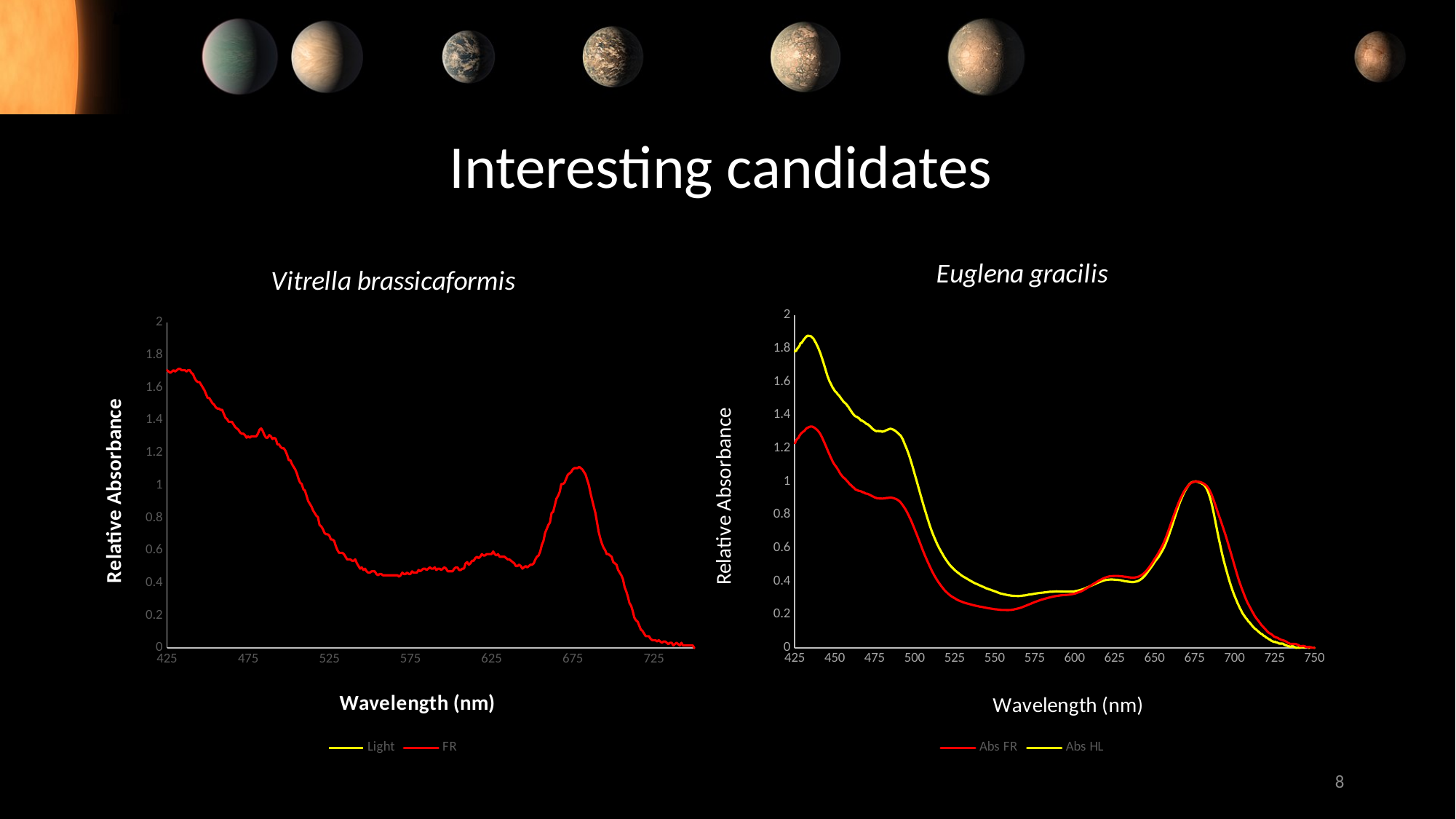
In the Vitrella brassicaformis chart, is the FR value at 725 nm greater or less than 0.2? less In the Vitrella brassicaformis chart, is the FR value at 575 nm greater or less than 0.6? less In the Euglena gracilis chart, is the Abs HL value at 425 nm greater or less than 1.6? greater In the Euglena gracilis chart, which series has the higher value at 450 nm, Abs FR or Abs HL? Abs HL What is the x-axis label of the Euglena gracilis chart? Wavelength (nm) What kind of chart is the Vitrella brassicaformis chart on the left? line chart How many series does the legend of the Euglena gracilis chart list? 2 How many series does the legend of the Vitrella brassicaformis chart list? 2 What kind of chart is the Euglena gracilis chart on the right? line chart In the Euglena gracilis chart, do the Abs HL values rise or fall between 425 nm and 575 nm? fall